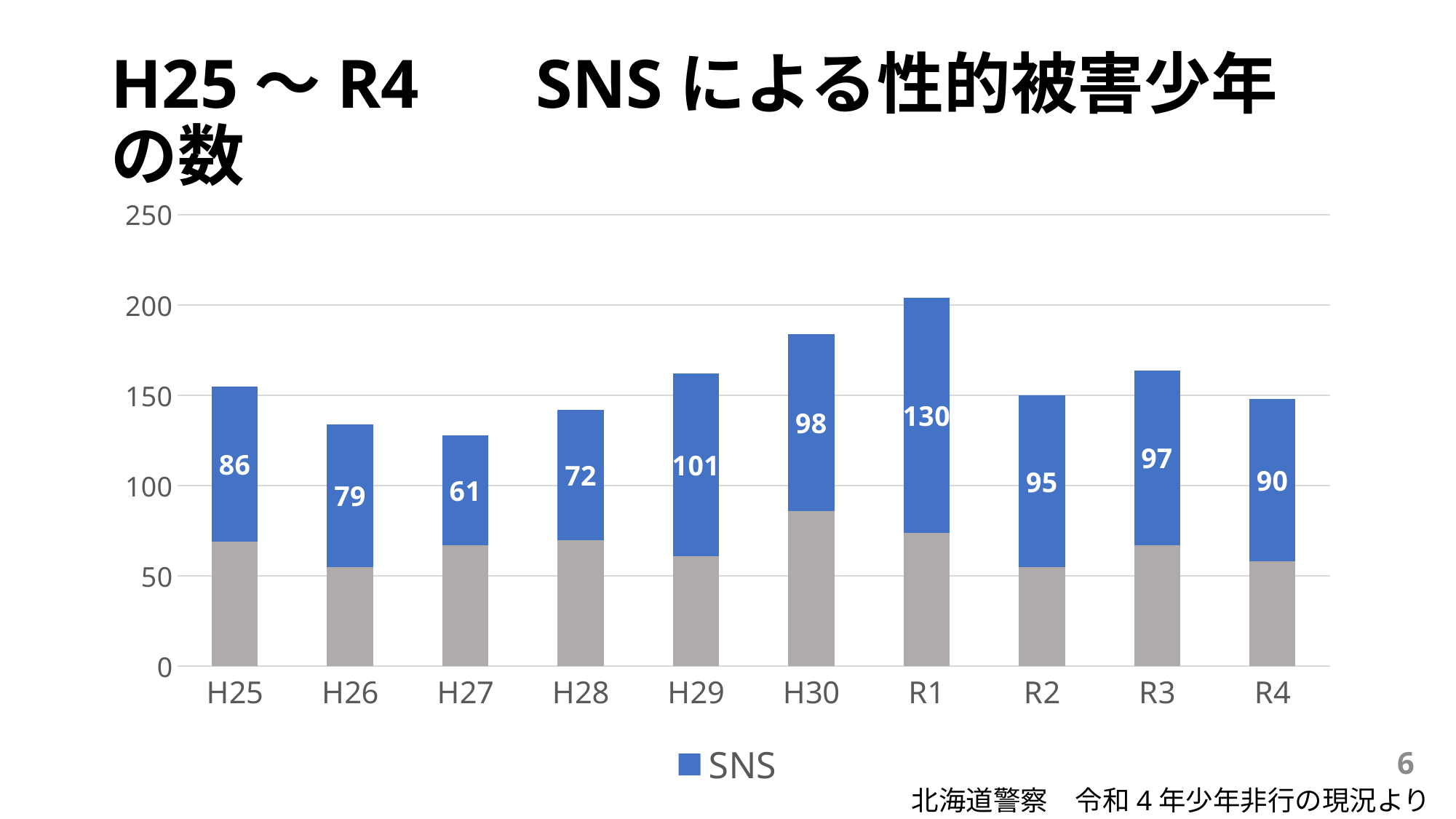
What is the SNS value for R1? 130 Which year has the lowest SNS value? H27 How many series does the legend list? 1 Which has a larger SNS value, H29 or H30? H29 What kind of chart is shown on the slide? Bar chart Which year has the highest SNS value? R1 Is the total height of the H27 bar greater or less than 150? less How many years are shown on the x axis? 10 Is the total height of the H30 bar greater or less than 150? greater What is the SNS value for H27? 61 What is the SNS value for R4? 90 What is the difference between the SNS values for R1 and H27? 69